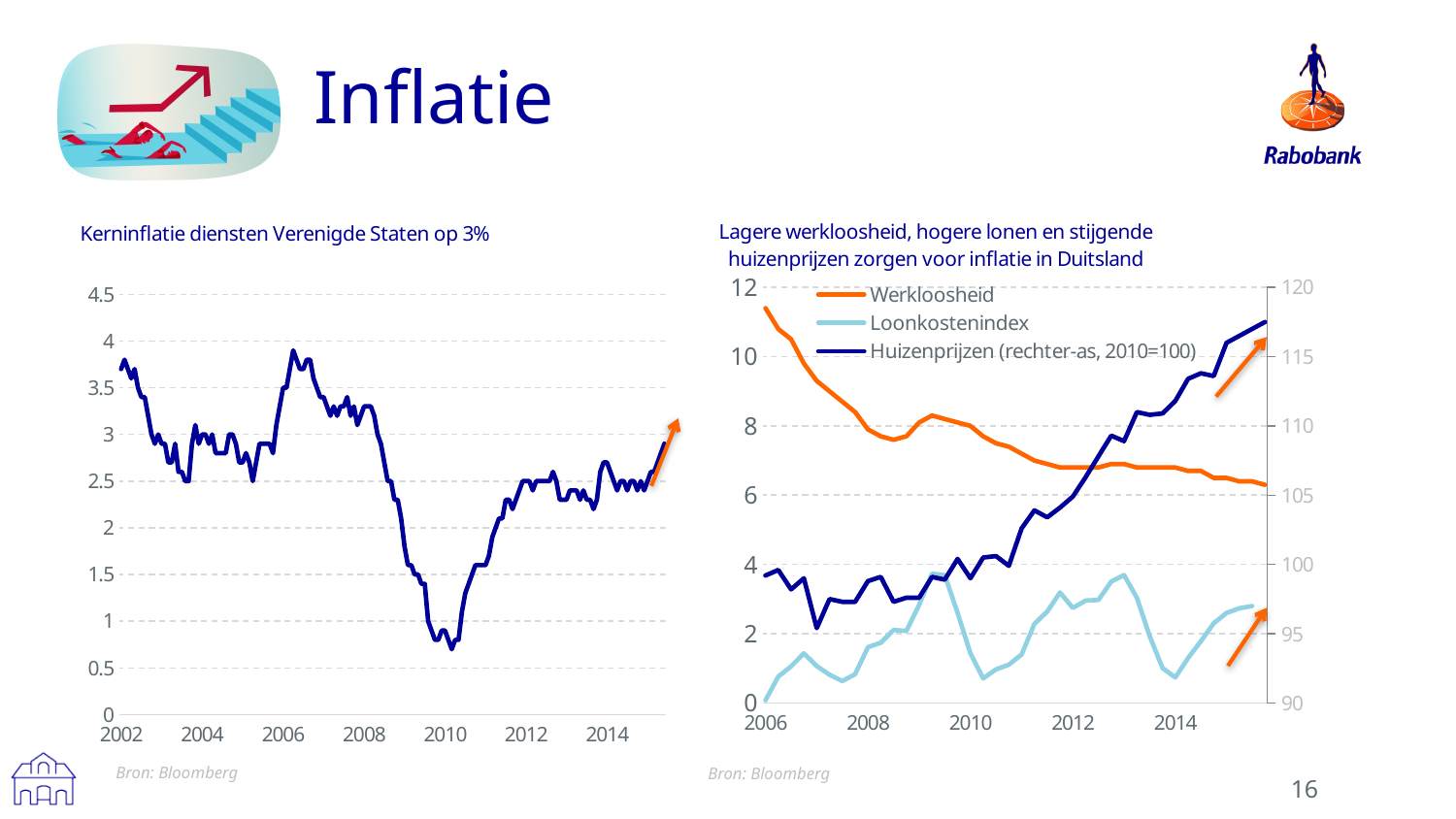
In the right chart, does the Huizenprijzen line rise or fall from 2010 to the end of the series? rise In the right chart, which is larger in 2014: Werkloosheid or Loonkostenindex? Werkloosheid What is the source cited below both charts? Bloomberg In the right chart, is the Huizenprijzen value at the end of the series greater or less than 115 on the right axis? greater In the left chart, is the value at the start of 2002 greater or less than 3.5? greater How many series does the legend of the right chart list? 3 In the left chart, does the line rise or fall between 2008 and 2010? fall In the right chart, does the Werkloosheid line rise or fall from 2006 to the end of the series? fall In the left chart, is the lowest value, reached around 2010, greater or less than 1? less What kind of chart is the left chart, 'Kerninflatie diensten Verenigde Staten op 3%'? line chart In the right chart, which series is plotted on the right axis? Huizenprijzen (rechter-as, 2010=100)